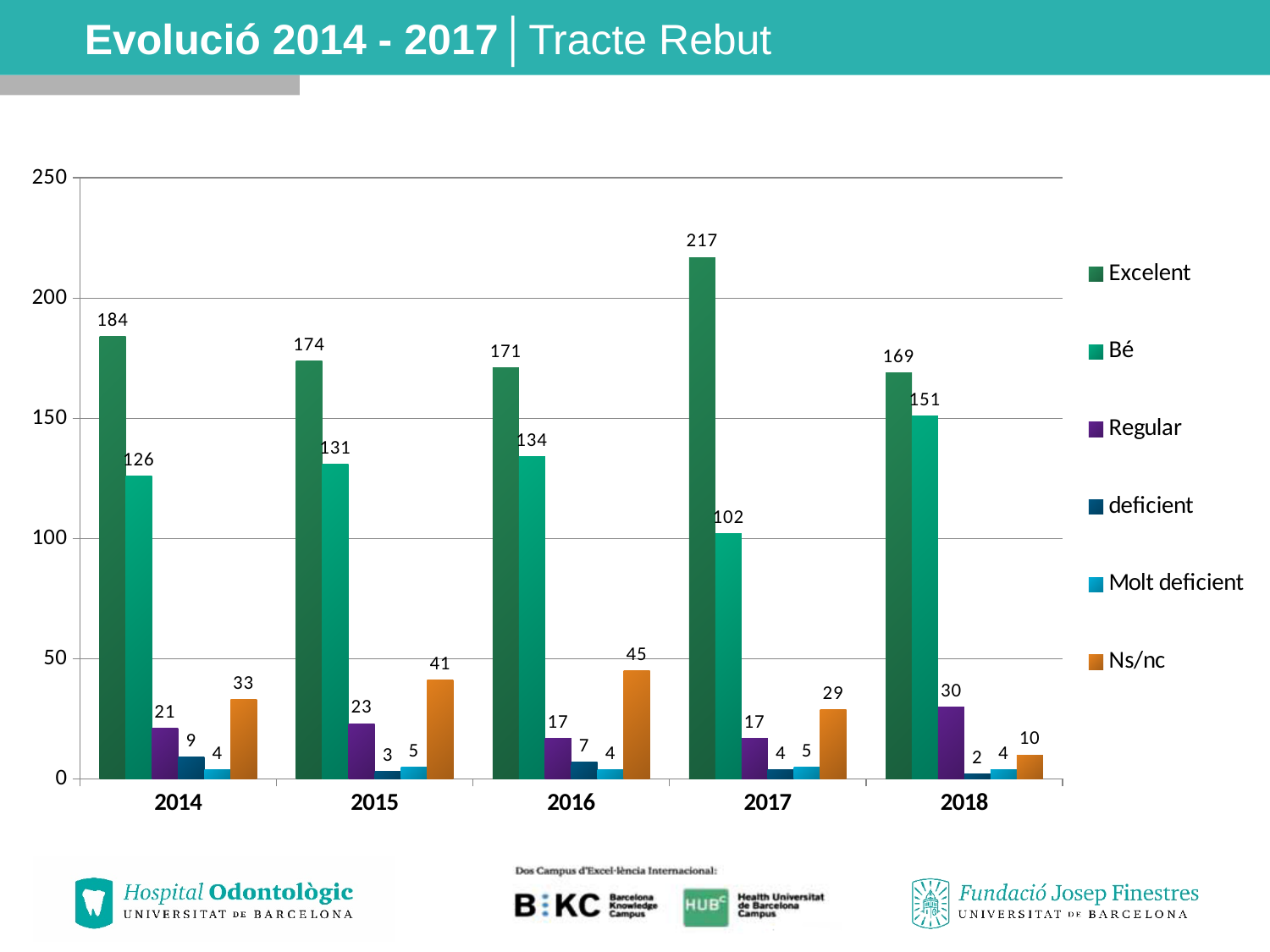
What is the value for Bé in 2018? 151 Which is larger in 2018: the Regular value or the Ns/nc value? Regular Does the Ns/nc value rise or fall from 2016 to 2018? Fall What kind of chart is shown on the slide? Bar chart How many years are shown on the x axis? 5 In which year is the Excelent value highest? 2017 How many series does the legend list? 6 What is the value for Ns/nc in 2016? 45 In which year is the Bé value lowest? 2017 What is the difference between the Excelent and Bé values in 2014? 58 What is the value for Excelent in 2017? 217 What is the value for Regular in 2015? 23